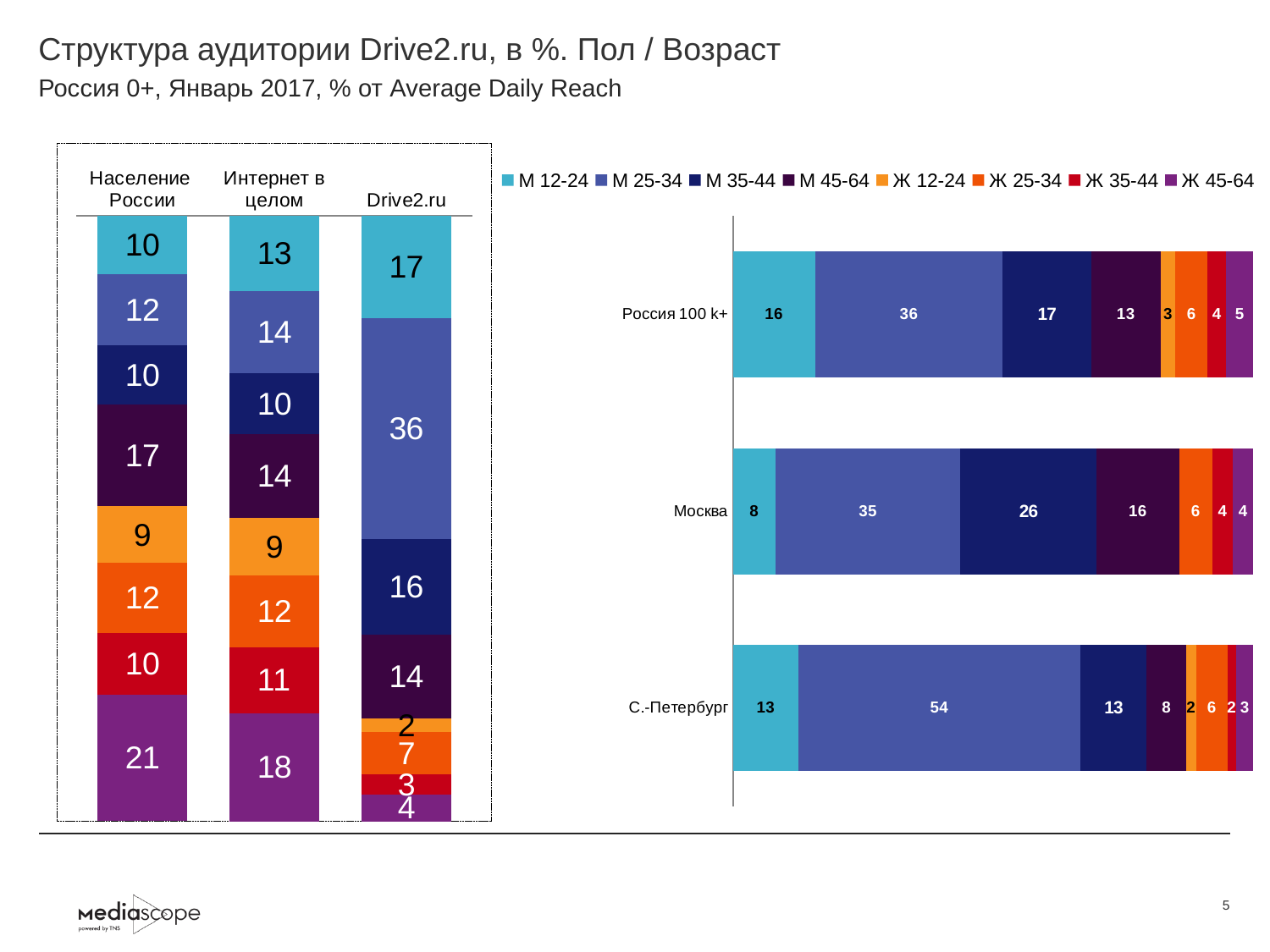
In the left chart, which segment is the largest in the Drive2.ru bar? М 25-34 In the right chart, what is the difference between the М 35-44 value for Москва and the М 35-44 value for Россия 100 k+? 9 How many categories are shown in the right chart? 3 In the left chart, what is the difference between the М 25-34 value for Drive2.ru and the М 25-34 value for Население России? 24 In the right chart, what is the value of the М 25-34 segment for С.-Петербург? 54 In the right chart, what is the value of the М 35-44 segment for Москва? 26 In the left chart, which has the larger Ж 45-64 value: Население России or Интернет в целом? Население России In the right chart, which category has the highest М 25-34 value? С.-Петербург In the left chart, what is the value of the М 25-34 segment for Drive2.ru? 36 What kind of chart is the chart on the right? Stacked bar chart How many series does the legend list? 8 In the left chart, what is the value of the Ж 45-64 segment for Население России? 21